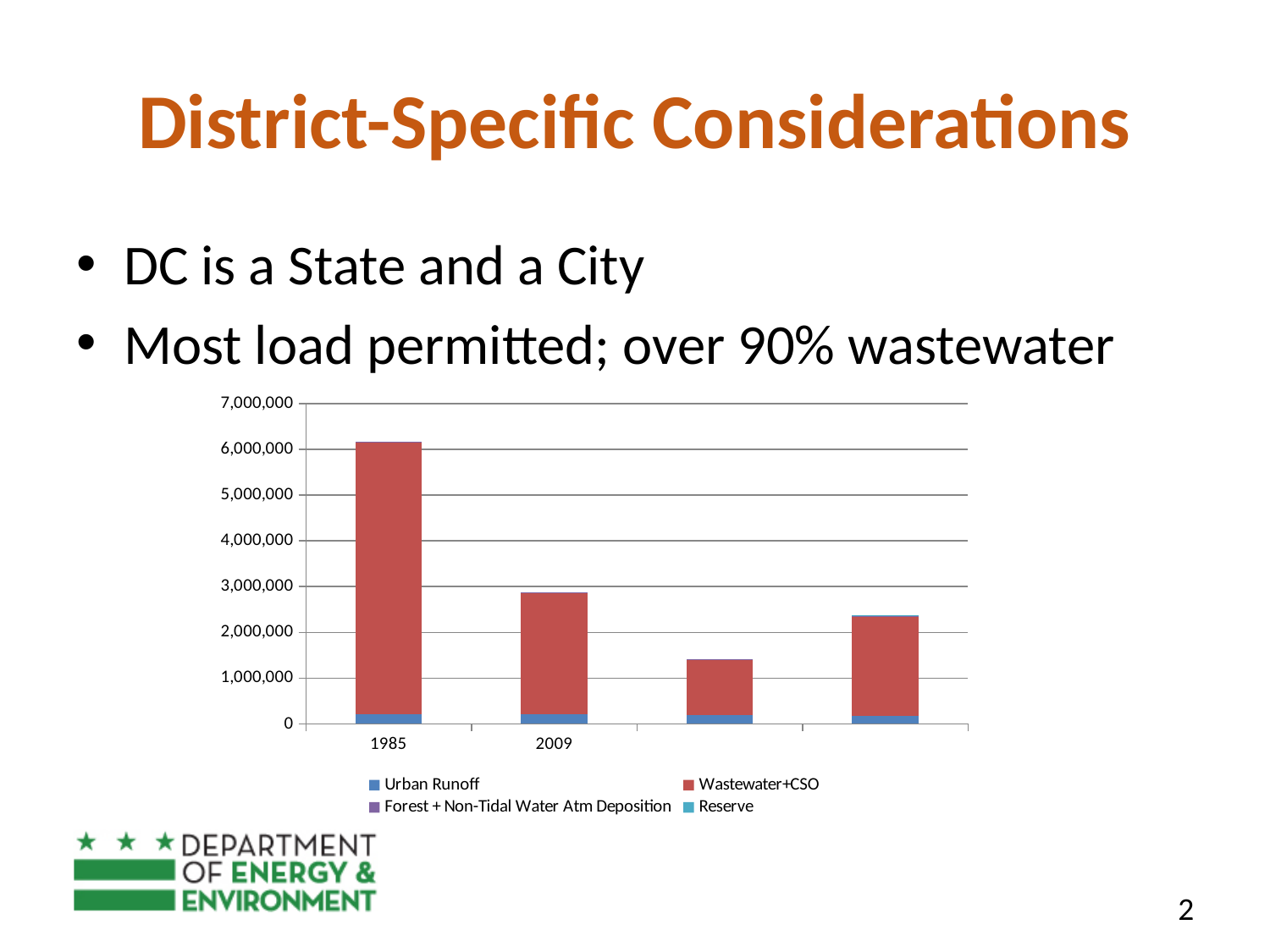
Is the total value of the 2009 bar greater or less than 2,000,000? greater How many series does the chart legend list? 4 How many bars are plotted in the chart? 4 Which series makes up the largest part of each stacked bar? Wastewater+CSO Is the total value of the 2009 bar greater or less than 3,000,000? less What colour represents Wastewater+CSO in the chart? red Of the labeled years, which has the highest total load? 1985 What kind of chart is shown on the slide? stacked bar chart Is the total value of the 1985 bar greater or less than 5,000,000? greater Which bar is taller, 1985 or 2009? 1985 What is the highest value shown on the chart's vertical axis? 7,000,000 Does the total load rise or fall from 1985 to 2009? fall